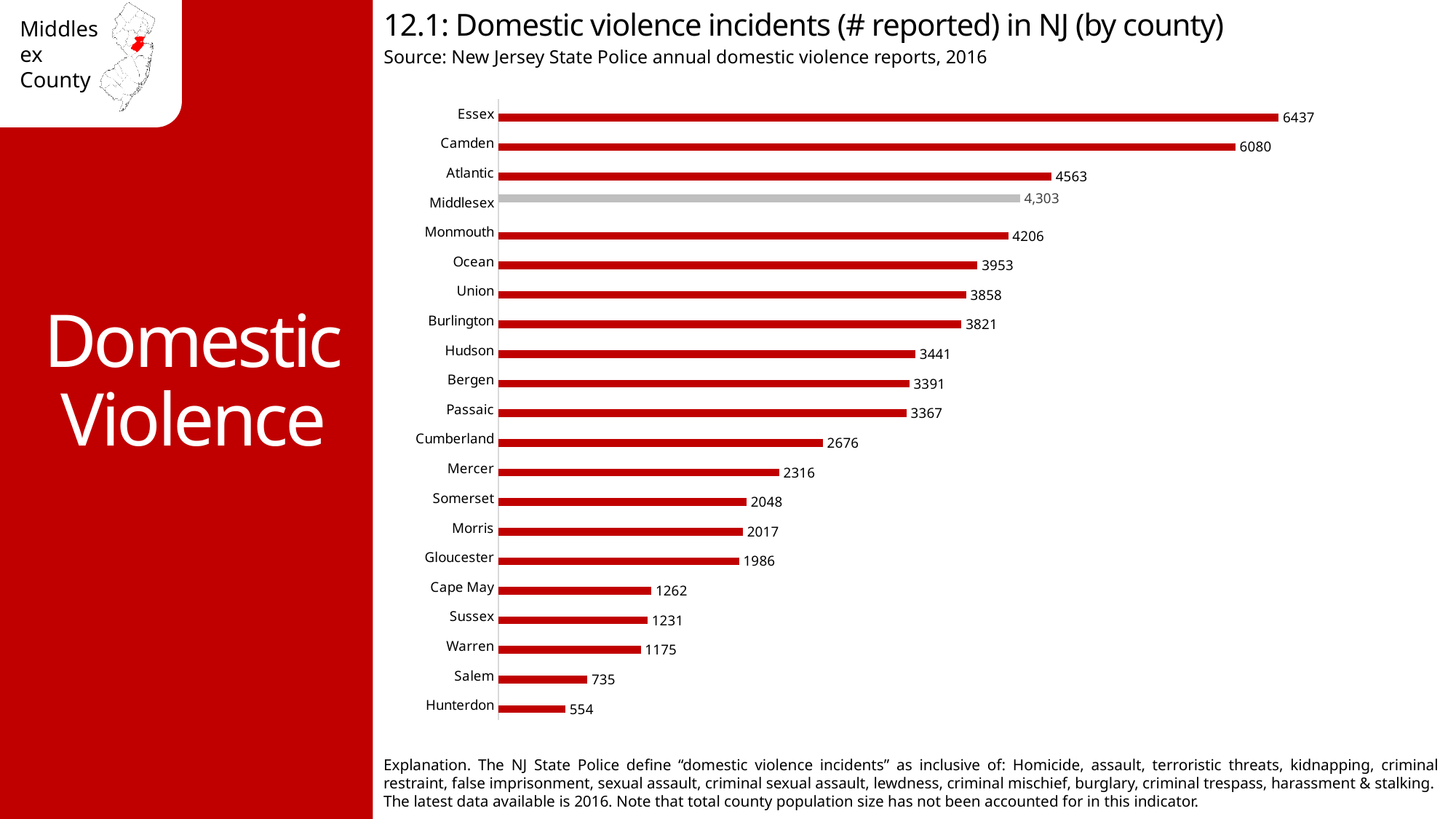
Which county has the lowest number of reported domestic violence incidents? Hunterdon Which county's bar is shown in grey rather than red? Middlesex What is the difference between the values for Essex and Camden? 357 Which county has more reported incidents, Atlantic or Ocean? Atlantic Which county has more reported incidents, Salem or Warren? Warren What type of chart is used on this slide? Bar chart How many domestic violence incidents were reported in Middlesex County? 4,303 How many domestic violence incidents were reported in Essex County? 6437 What is the value shown for Hunterdon? 554 How many counties are shown in the chart? 21 Which county has the highest number of reported domestic violence incidents? Essex What is the difference between the values for Middlesex and Monmouth? 97